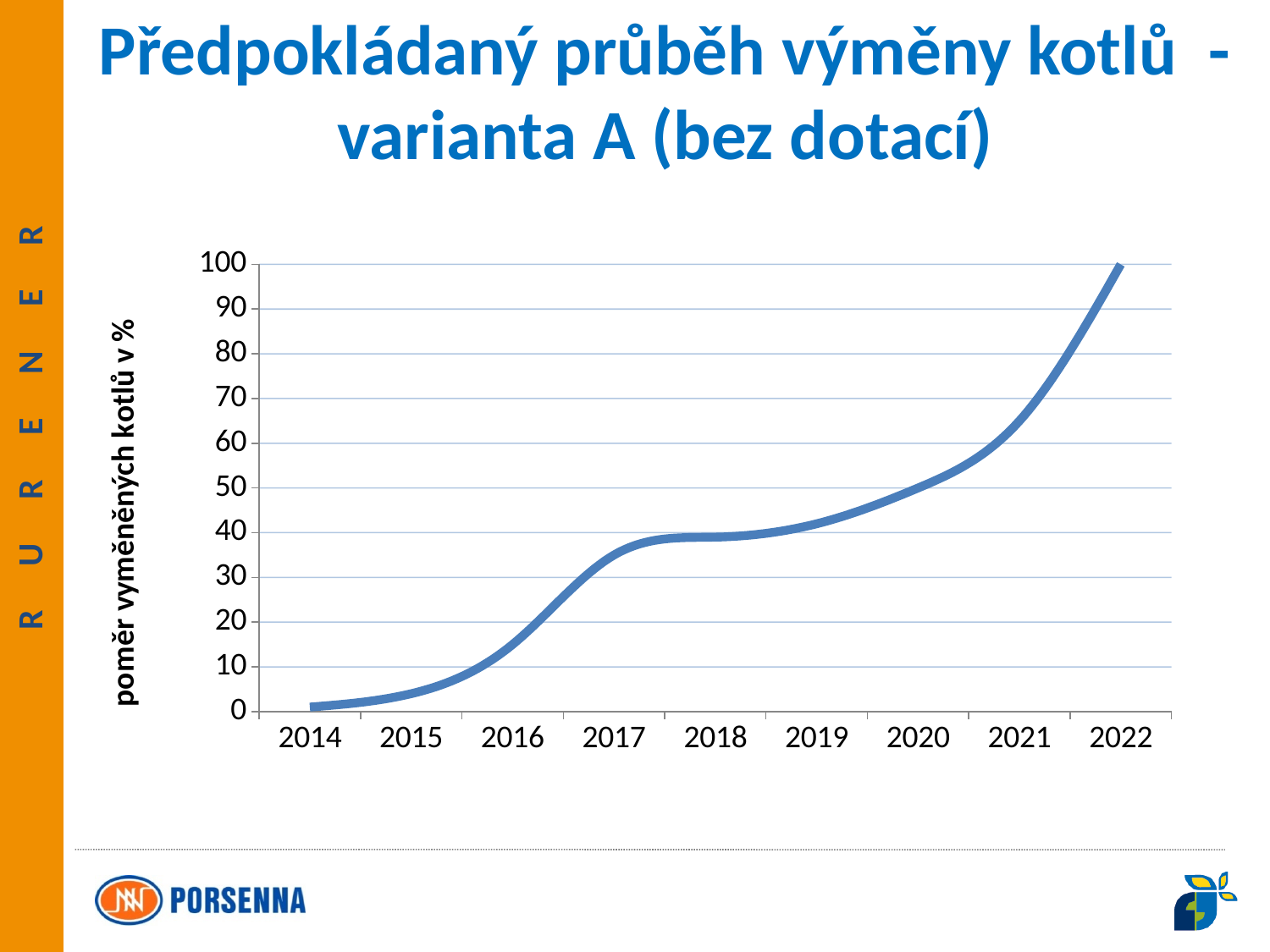
How many years are shown on the x axis? 9 What kind of chart is shown on the slide? line chart Which year has a larger share of replaced boilers, 2018 or 2021? 2021 Which year has the lowest share of replaced boilers? 2014 Is the value for 2016 greater or less than 20? less Is the value for 2021 greater or less than 60? greater Is the value for 2017 greater or less than 30? greater Does the share of replaced boilers rise or fall from 2014 to 2022? rise Which year has the highest share of replaced boilers? 2022 What is the title of the chart on the slide? Předpokládaný průběh výměny kotlů - varianta A (bez dotací) What is the label of the vertical axis? poměr vyměněných kotlů v %